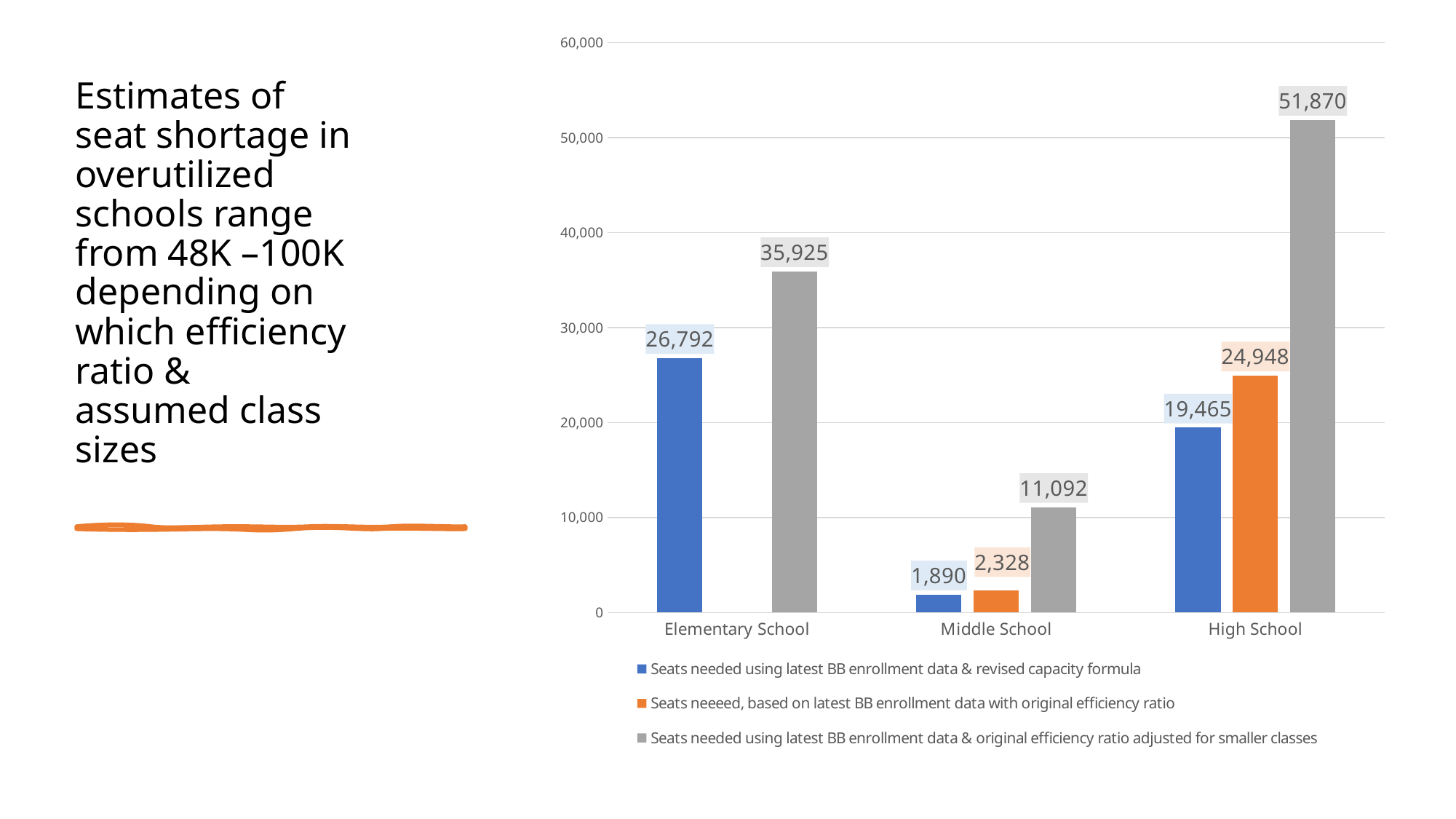
How many series does the legend list? 3 Which school level has the highest value in the series 'Seats needed using latest BB enrollment data & original efficiency ratio adjusted for smaller classes'? High School How many school-level categories are shown on the x axis? 3 What kind of chart is shown on the slide? bar chart Is the value for Middle School in the series 'Seats needed using latest BB enrollment data & original efficiency ratio adjusted for smaller classes' greater or less than 10,000? greater What is the difference between the two High School values 24,948 and 19,465? 5,483 For Elementary School, which is larger: the value for 'Seats needed using latest BB enrollment data & revised capacity formula' or the value for 'Seats needed using latest BB enrollment data & original efficiency ratio adjusted for smaller classes'? Seats needed using latest BB enrollment data & original efficiency ratio adjusted for smaller classes What is the value for Elementary School in the series 'Seats needed using latest BB enrollment data & revised capacity formula'? 26,792 What is the value for High School in the series 'Seats needed using latest BB enrollment data & original efficiency ratio adjusted for smaller classes'? 51,870 Which school level has no bar for the series 'Seats neeeed, based on latest BB enrollment data with original efficiency ratio'? Elementary School Which school level has the lowest value in the series 'Seats needed using latest BB enrollment data & revised capacity formula'? Middle School What is the value for Middle School in the series 'Seats neeeed, based on latest BB enrollment data with original efficiency ratio'? 2,328